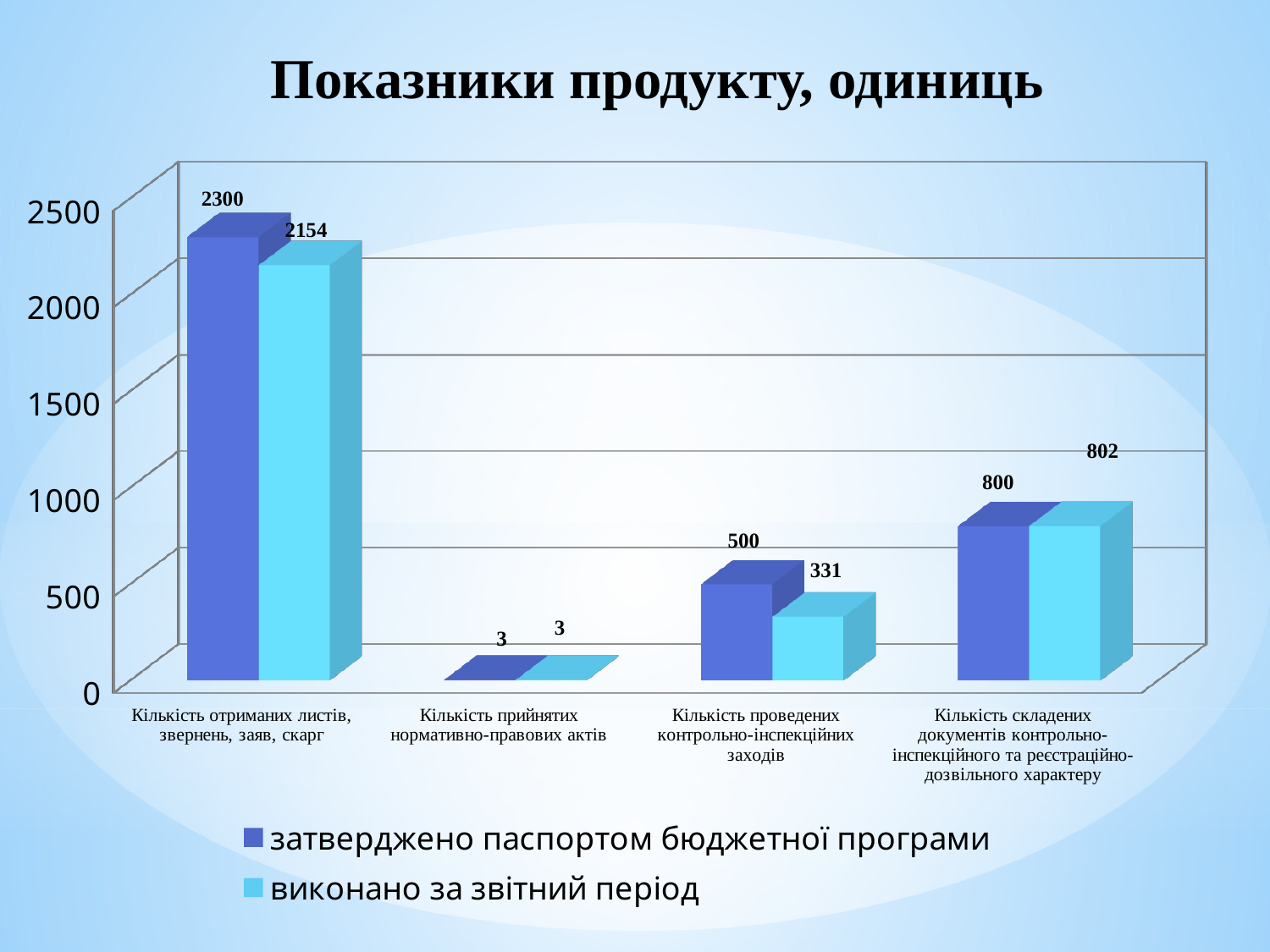
Which category has the lowest value for 'виконано за звітний період'? Кількість прийнятих нормативно-правових актів Which category has the highest value for 'затверджено паспортом бюджетної програми'? Кількість отриманих листів, звернень, заяв, скарг How many categories are shown on the x axis? 4 What is the title of the chart? Показники продукту, одиниць What is the value for 'виконано за звітний період' for 'Кількість складених документів контрольно-інспекційного та реєстраційно-дозвільного характеру'? 802 What kind of chart is shown on the slide? Bar chart What is the value for 'затверджено паспортом бюджетної програми' for 'Кількість отриманих листів, звернень, заяв, скарг'? 2300 For 'Кількість складених документів контрольно-інспекційного та реєстраційно-дозвільного характеру', which is larger: 'затверджено паспортом бюджетної програми' or 'виконано за звітний період'? виконано за звітний період What is the value for 'виконано за звітний період' for 'Кількість проведених контрольно-інспекційних заходів'? 331 How many series does the legend list? 2 What is the difference between the 'затверджено паспортом бюджетної програми' and 'виконано за звітний період' values for 'Кількість отриманих листів, звернень, заяв, скарг'? 146 What is the difference between the 'затверджено паспортом бюджетної програми' and 'виконано за звітний період' values for 'Кількість проведених контрольно-інспекційних заходів'? 169